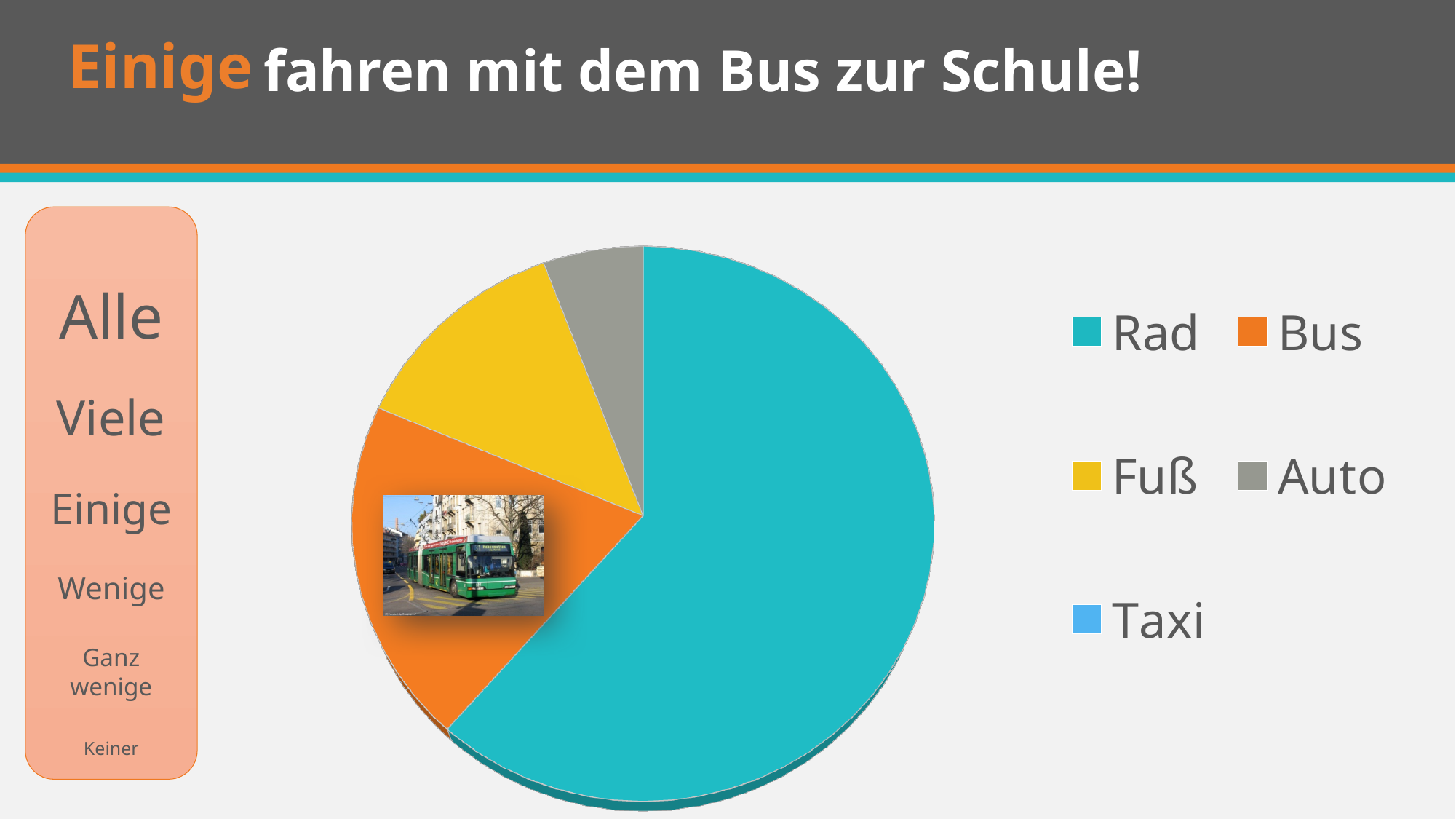
Which slice is larger, Bus or Auto? Bus Which legend entry has no visible slice in the pie chart? Taxi How many slices are visible in the pie chart? 4 Is the share of the pie for Rad greater or less than 50%? greater Which slice is larger, Rad or Fuß? Rad What kind of chart is shown on the slide? pie chart Which category has the largest slice of the pie chart? Rad What colour is the Bus slice in the pie chart? orange Which slice is larger, Fuß or Auto? Fuß How many entries does the legend of the pie chart list? 5